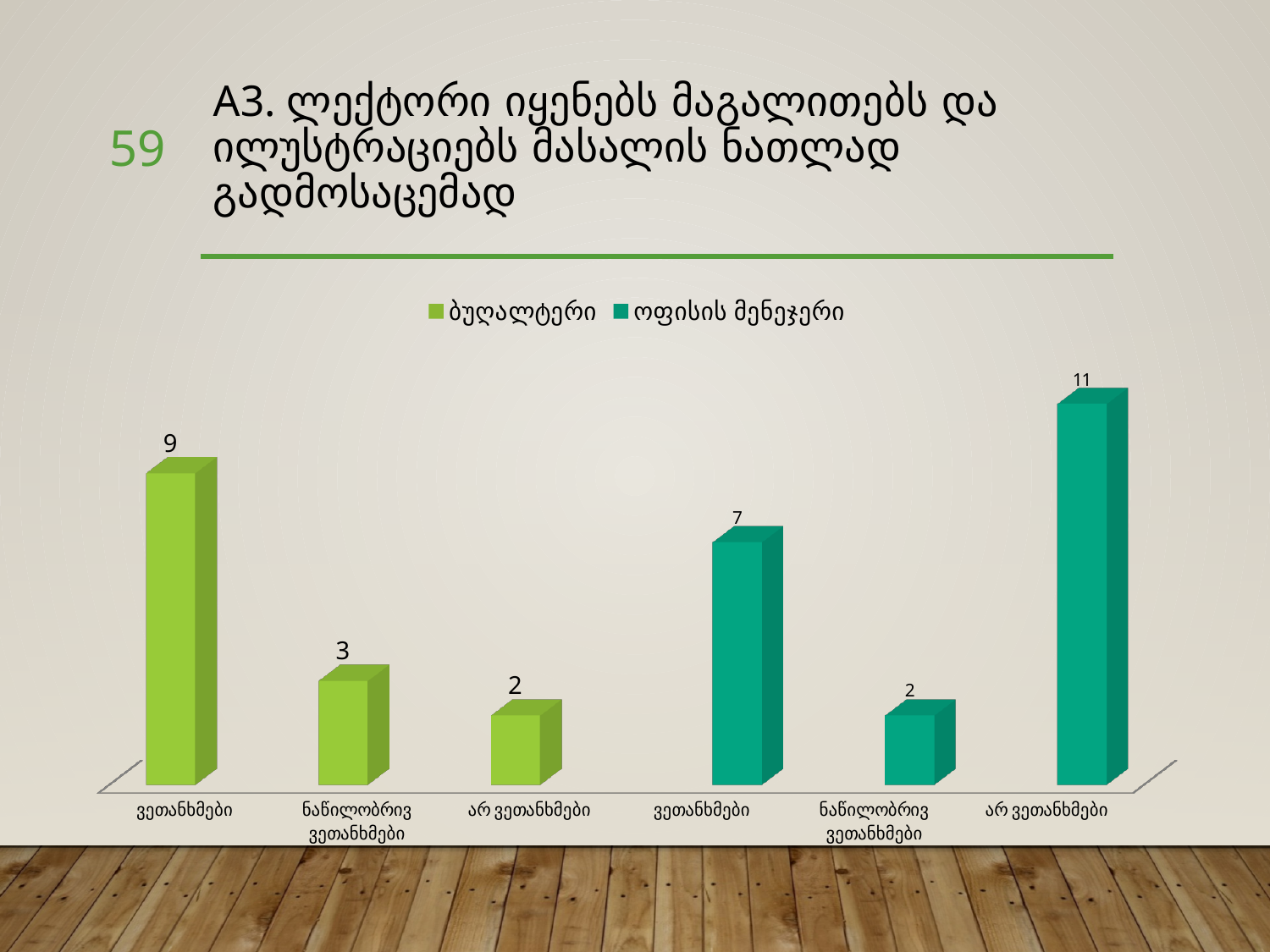
What is the total of the three ბუღალტერი values? 14 What is the value for ვეთანხმები in the ოფისის მენეჯერი series? 7 Which is larger: the ბუღალტერი value for ვეთანხმები or the ოფისის მენეჯერი value for ვეთანხმები? ბუღალტერი What is the value for ვეთანხმები in the ბუღალტერი series? 9 How many bars are plotted in the chart? 6 What kind of chart is shown on the slide? Bar chart How many series does the legend list? 2 What is the difference between the ოფისის მენეჯერი value for არ ვეთანხმები and the ბუღალტერი value for არ ვეთანხმები? 9 What is the value for ნაწილობრივ ვეთანხმები in the ბუღალტერი series? 3 Which category has the highest value in the ოფისის მენეჯერი series? არ ვეთანხმები Which category has the lowest value in the ბუღალტერი series? არ ვეთანხმები What is the value for არ ვეთანხმები in the ოფისის მენეჯერი series? 11